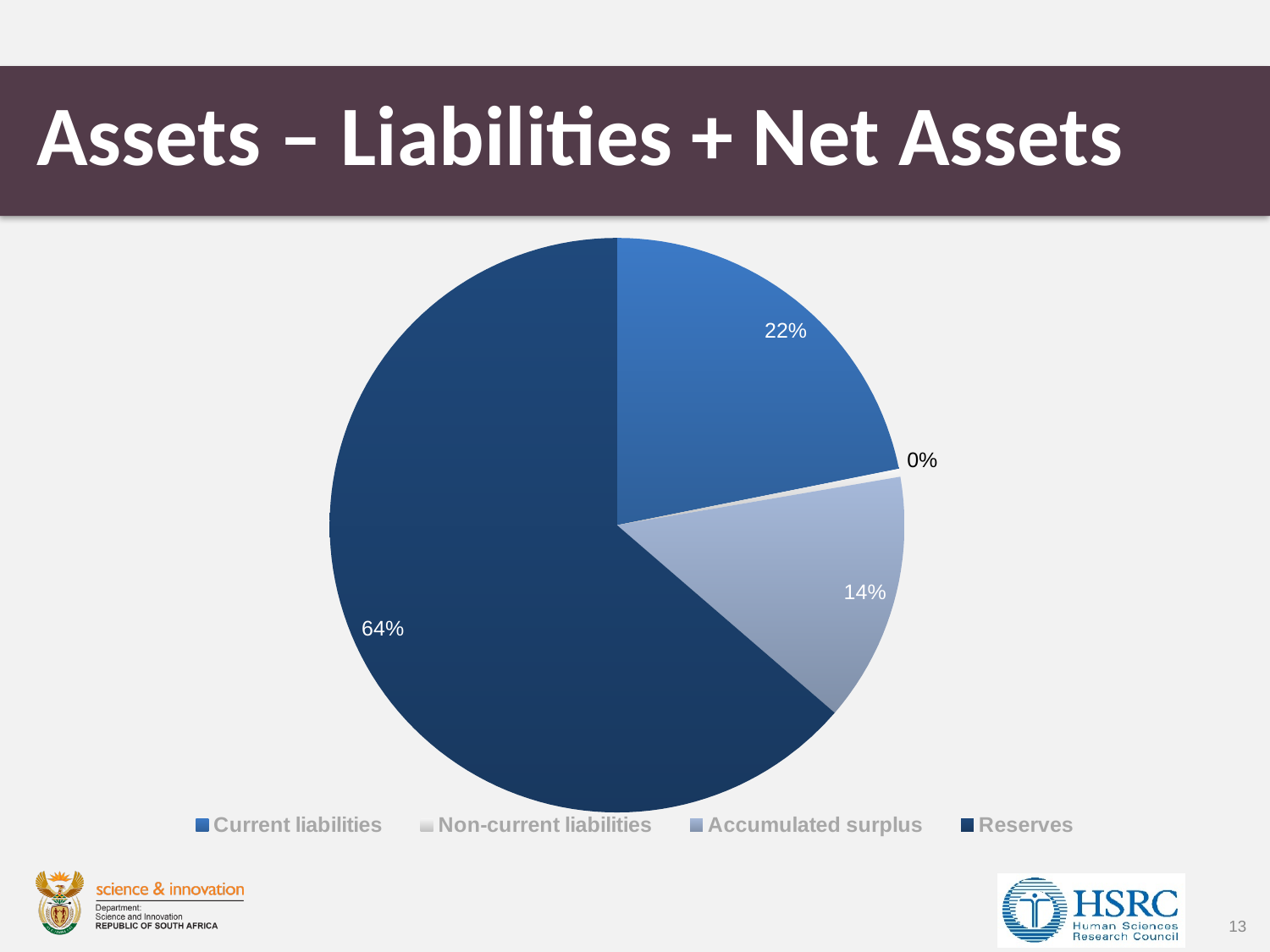
What is the title of the slide containing the chart? Assets – Liabilities + Net Assets What is the difference in percentage points between Reserves and Current liabilities? 42 What share of the pie does Accumulated surplus represent? 14% What is the difference in percentage points between Current liabilities and Accumulated surplus? 8 How many categories does the legend list? 4 What share of the pie does Non-current liabilities represent? 0% What share of the pie does Reserves represent? 64% What kind of chart is shown on the slide? Pie chart Which is larger, the slice for Current liabilities or the slice for Accumulated surplus? Current liabilities Which category has the smallest slice of the pie? Non-current liabilities Which category has the largest slice of the pie? Reserves